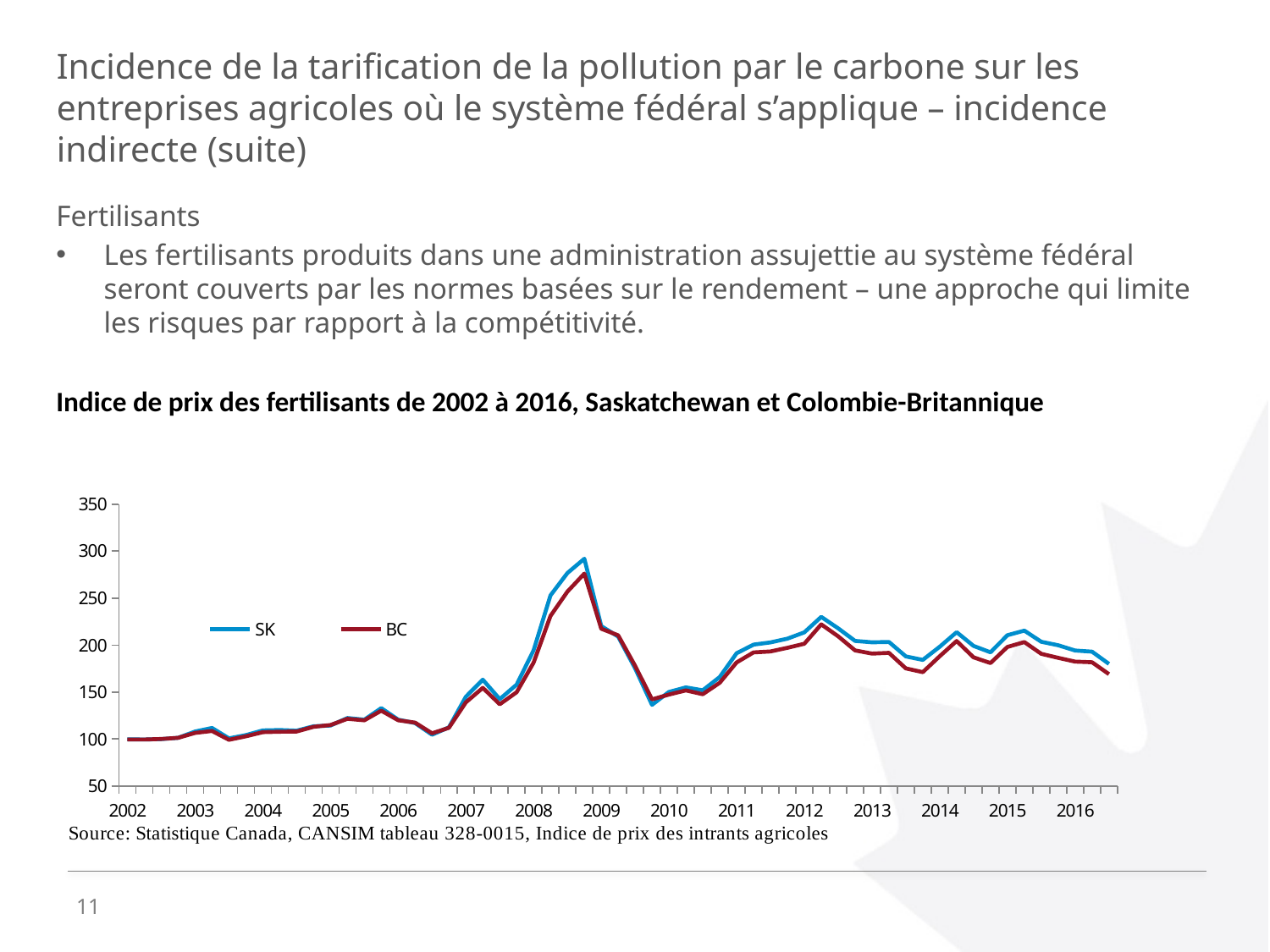
Is the value for BC at the start of 2010 greater or less than 200? less Is the value for SK at the end of 2016 greater or less than 150? greater Is the peak value for SK in 2008 greater or less than 250? greater What are the two series named in the legend? SK and BC How many series does the legend list? 2 In which year does the BC series reach its highest value? 2008 What kind of chart is shown on the slide? Line chart Do the values rise or fall from 2002 to the 2008 peak? Rise At the end of 2016, which series has the higher value, SK or BC? SK In which year does the SK series reach its highest value? 2008 How many years are labelled on the x axis? 15 What is the title of the chart? Indice de prix des fertilisants de 2002 à 2016, Saskatchewan et Colombie-Britannique